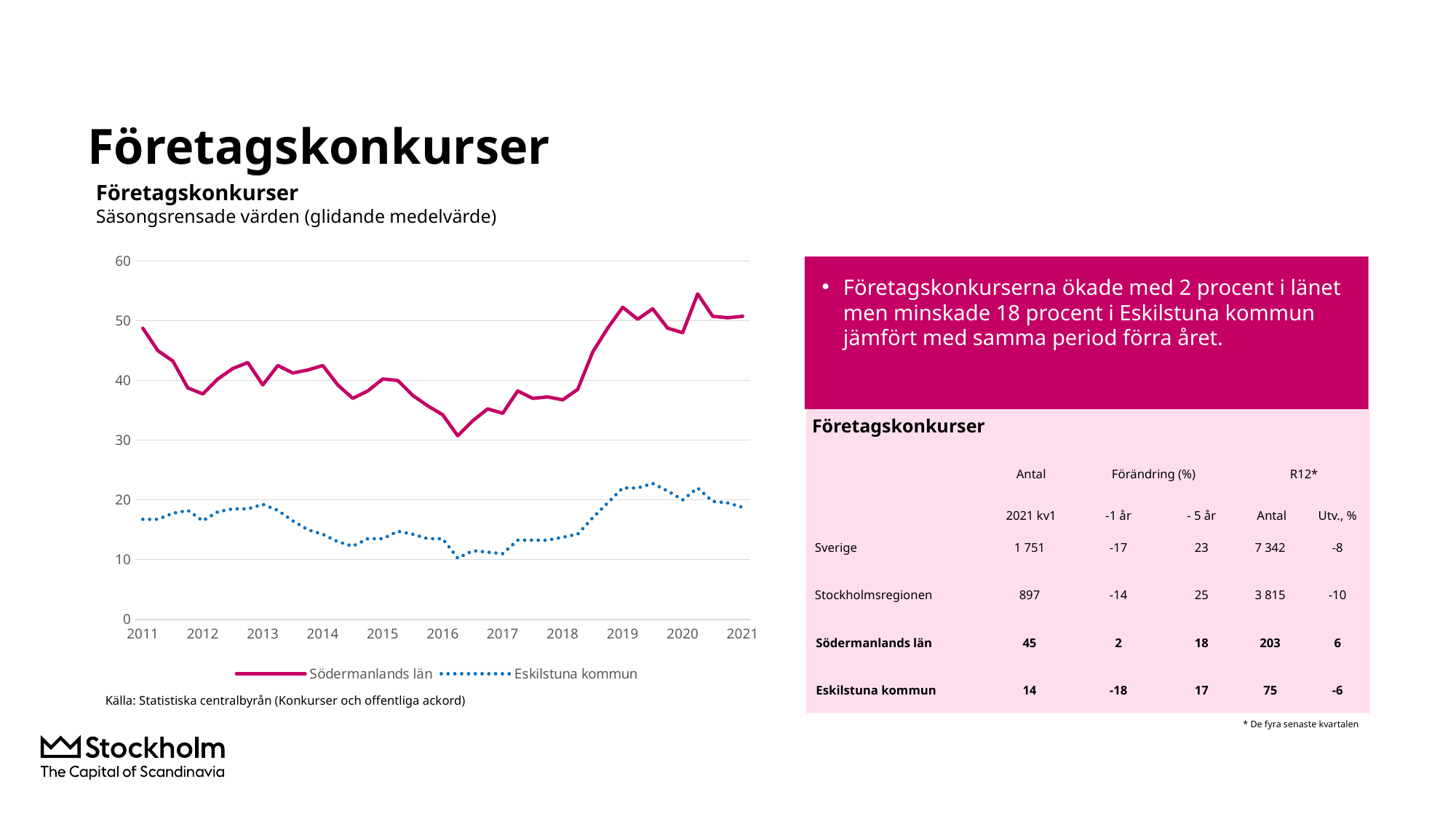
How many series does the chart legend list? 2 Does the Eskilstuna kommun line rise or fall between 2013 and 2014? fall What is the subtitle printed under the chart title 'Företagskonkurser'? Säsongsrensade värden (glidande medelvärde) Is the value for Eskilstuna kommun in 2019 greater or less than 20? greater Does the Södermanlands län line rise or fall between 2018 and 2019? rise Is the value for Eskilstuna kommun at the start of 2011 greater or less than 20? less Is the lowest value of the Södermanlands län line, around 2016, greater or less than 40? less How many year labels are shown on the x axis of the chart? 11 Which series has the higher values throughout the chart, Södermanlands län or Eskilstuna kommun? Södermanlands län Which two series are shown in the chart legend? Södermanlands län and Eskilstuna kommun What kind of chart is shown on the slide? line chart